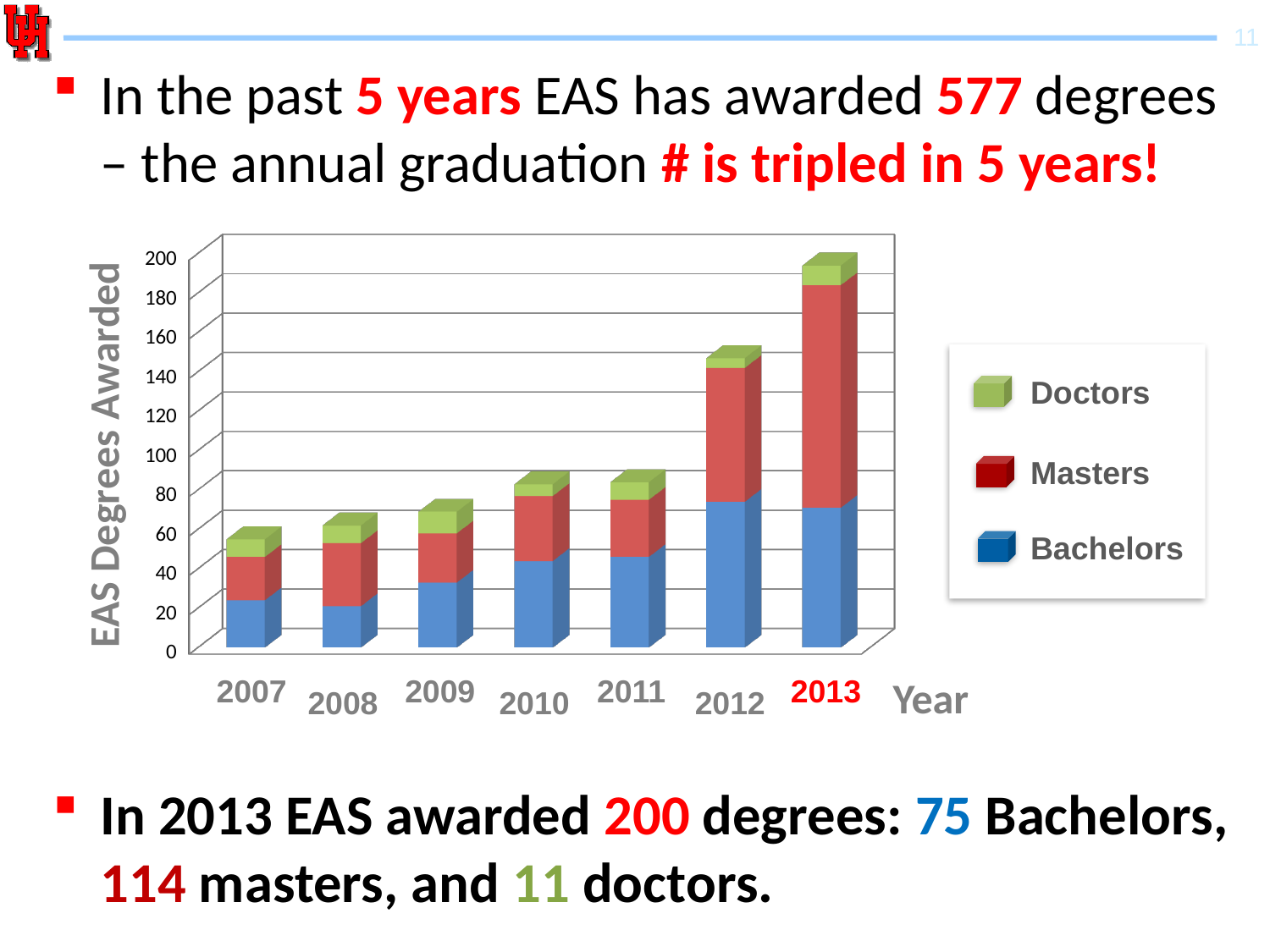
What is the total number of degrees awarded in 2013? 200 How many years are shown on the x axis of the chart? 7 Is the total number of degrees awarded in 2012 greater or less than 120? greater How many Bachelors degrees were awarded in 2013? 75 Which year has the lowest total number of EAS degrees awarded? 2007 Do the total degrees awarded generally rise or fall from 2007 to 2013? Rise What is the label of the vertical axis of the chart? EAS Degrees Awarded Which year has the highest total number of EAS degrees awarded? 2013 Is the total number of degrees awarded in 2007 greater or less than 80? less What kind of chart is shown on the slide? Stacked bar chart Which year has a larger total of degrees awarded, 2011 or 2012? 2012 How many series does the chart legend list? 3